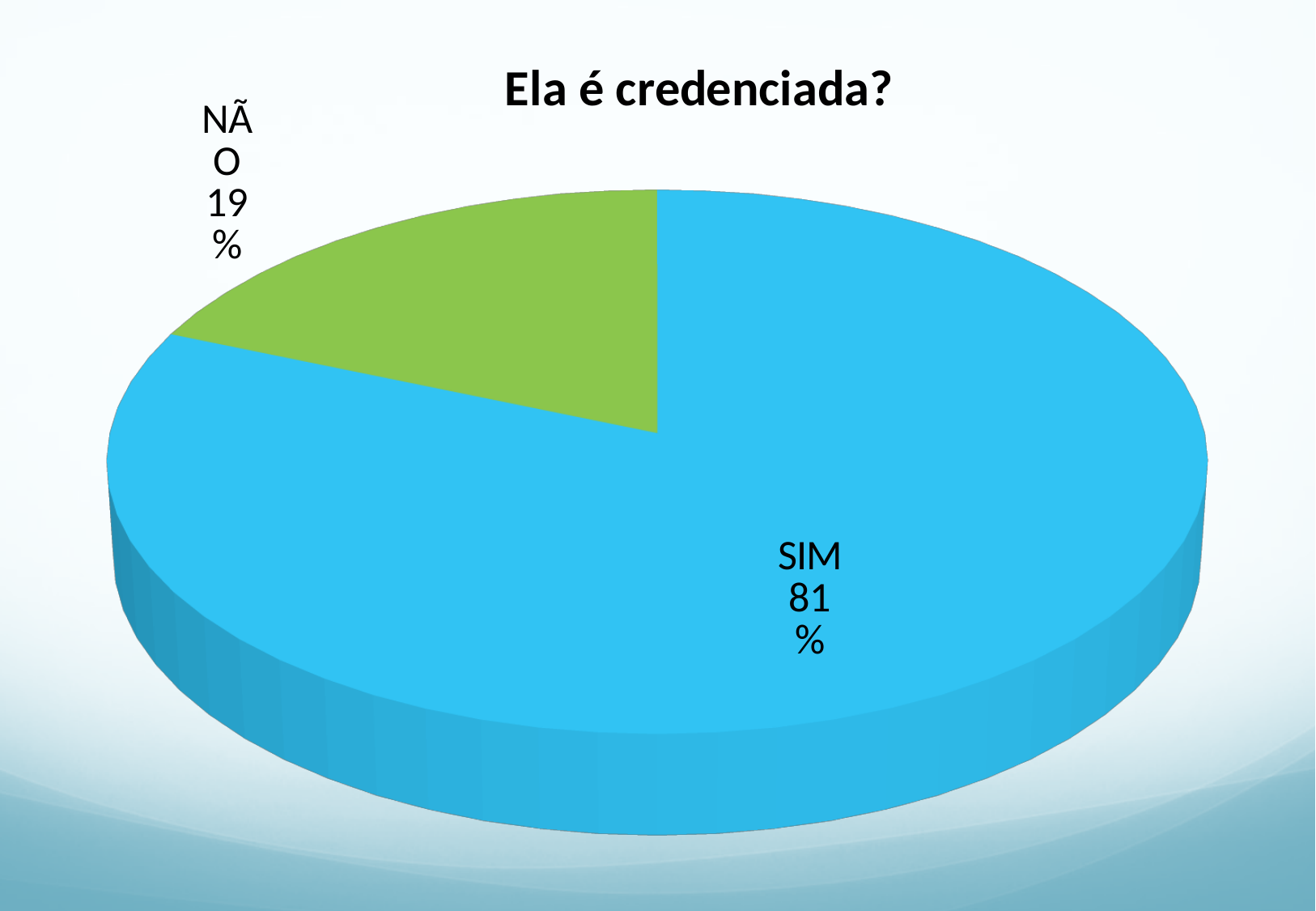
How many slices does the pie chart have? 2 What kind of chart is shown on the slide? pie chart What share of the pie does the SIM slice represent? 81% What percentage is shown for NÃO? 19% Which slice is the smallest? NÃO Which slice is the largest? SIM What is the title of the chart? Ela é credenciada? What colour is the NÃO slice? green What is the difference between the SIM and NÃO percentages? 62% Which is larger, SIM or NÃO? SIM What percentage is shown for SIM? 81%